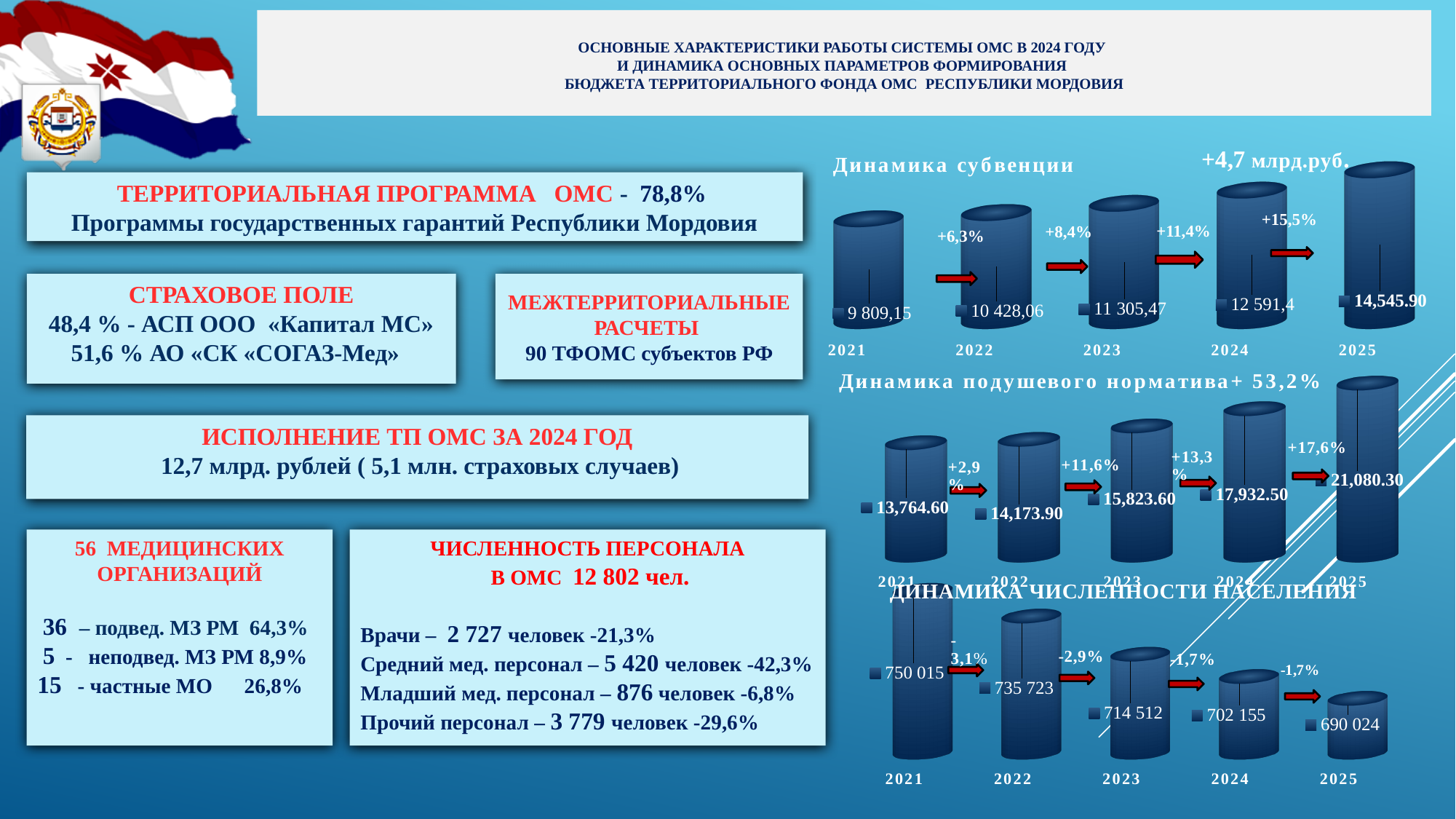
In the 'Динамика подушевого норматива' chart, what is the value for 2023? 15,823.60 In the 'ДИНАМИКА ЧИСЛЕННОСТИ НАСЕЛЕНИЯ' chart, which year has the lowest value? 2025 In the 'Динамика субвенции' chart, what is the value for 2021? 9 809,15 In the 'Динамика субвенции' chart, which year has the lowest value? 2021 In the 'ДИНАМИКА ЧИСЛЕННОСТИ НАСЕЛЕНИЯ' chart, do the values rise or fall from 2021 to 2025? fall In the 'Динамика подушевого норматива' chart, do the values rise or fall from 2021 to 2025? rise In the 'ДИНАМИКА ЧИСЛЕННОСТИ НАСЕЛЕНИЯ' chart, what is the value for 2022? 735 723 What kind of chart is the 'Динамика подушевого норматива' chart? bar chart In the 'ДИНАМИКА ЧИСЛЕННОСТИ НАСЕЛЕНИЯ' chart, what is the difference between the 2021 and 2022 values? 14 292 In the 'Динамика подушевого норматива' chart, which year has the highest value? 2025 How many years are shown in the 'Динамика субвенции' chart? 5 In the 'Динамика субвенции' chart, what is the value for 2025? 14,545.90